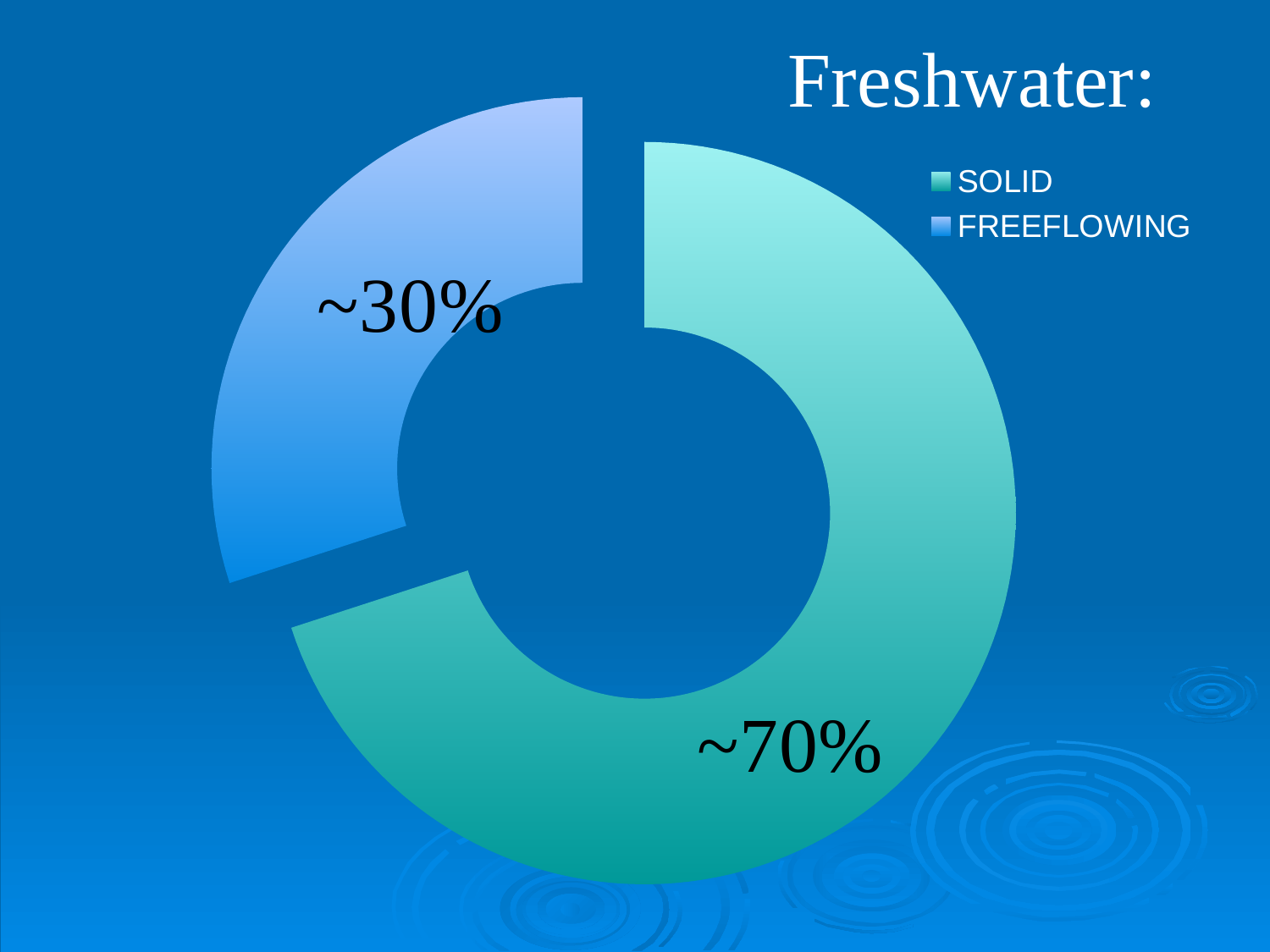
What share of freshwater is labelled as FREEFLOWING? ~30% What kind of chart is shown on the slide? doughnut chart Which category has the largest slice? SOLID What is the title of the chart? Freshwater: Which is larger, the SOLID slice or the FREEFLOWING slice? SOLID How many entries does the legend list? 2 Which legend entry is shown in blue? FREEFLOWING Is the share for SOLID greater or less than 50%? greater Is the share for FREEFLOWING greater or less than 50%? less What share of freshwater is labelled as SOLID? ~70% Which category has the smallest slice? FREEFLOWING How many slices does the chart have? 2